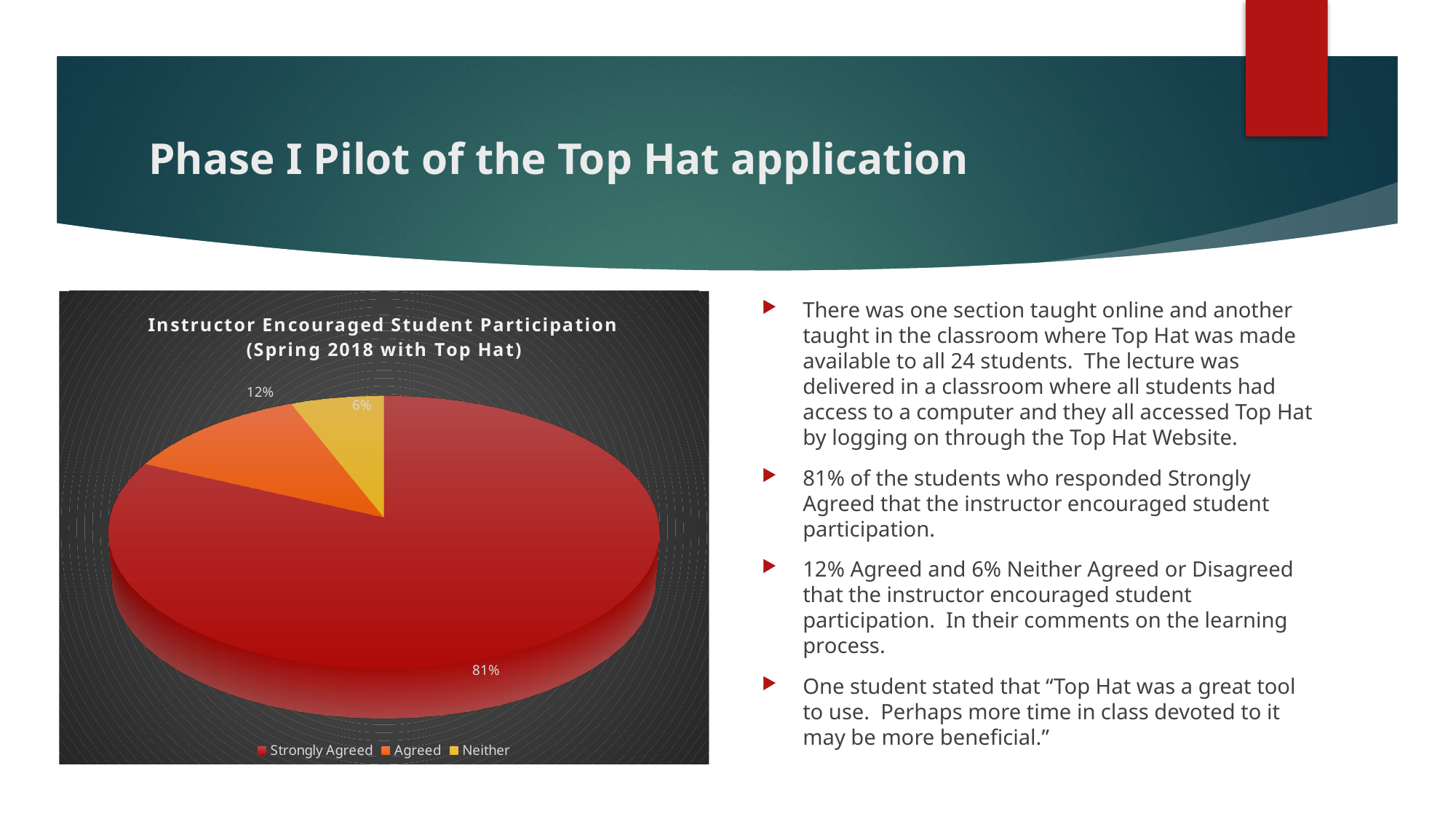
How many slices does the pie chart have? 3 How many entries does the legend list? 3 What share of the pie is labelled Neither? 6% What share of the pie is labelled Agreed? 12% What is the title of the pie chart? Instructor Encouraged Student Participation (Spring 2018 with Top Hat) What is the difference in percentage points between the Strongly Agreed and Agreed slices? 69 What share of the pie is labelled Strongly Agreed? 81% What colour is the Neither slice in the pie chart? Yellow Which category has the largest slice of the pie? Strongly Agreed Which slice is larger, Agreed or Neither? Agreed Which category has the smallest slice of the pie? Neither What kind of chart is shown on the slide? Pie chart